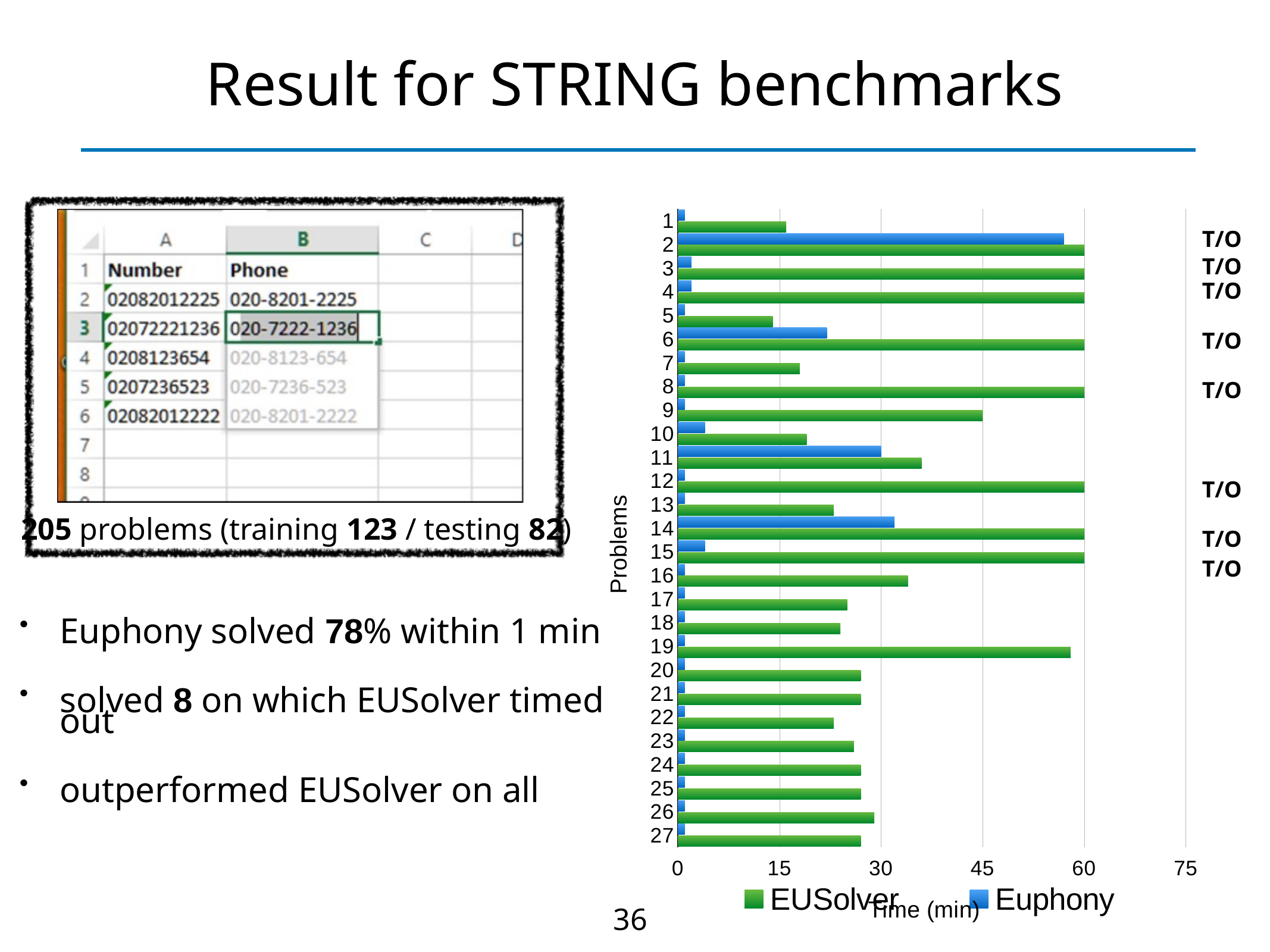
How many problems are plotted on the chart's vertical axis? 27 Which has the larger Euphony value, problem 2 or problem 3? problem 2 What is the title of the chart's horizontal axis? Time (min) What are the two series named in the chart legend? EUSolver and Euphony Is the Euphony value for problem 2 greater or less than 45? greater What kind of chart is shown on the slide? bar chart How many series does the chart legend list? 2 Is the EUSolver value for problem 19 greater or less than 45? greater Is the EUSolver value for problem 1 greater or less than 30? less Which problem has the highest Euphony value? problem 2 For problem 1, which series has the larger value, EUSolver or Euphony? EUSolver